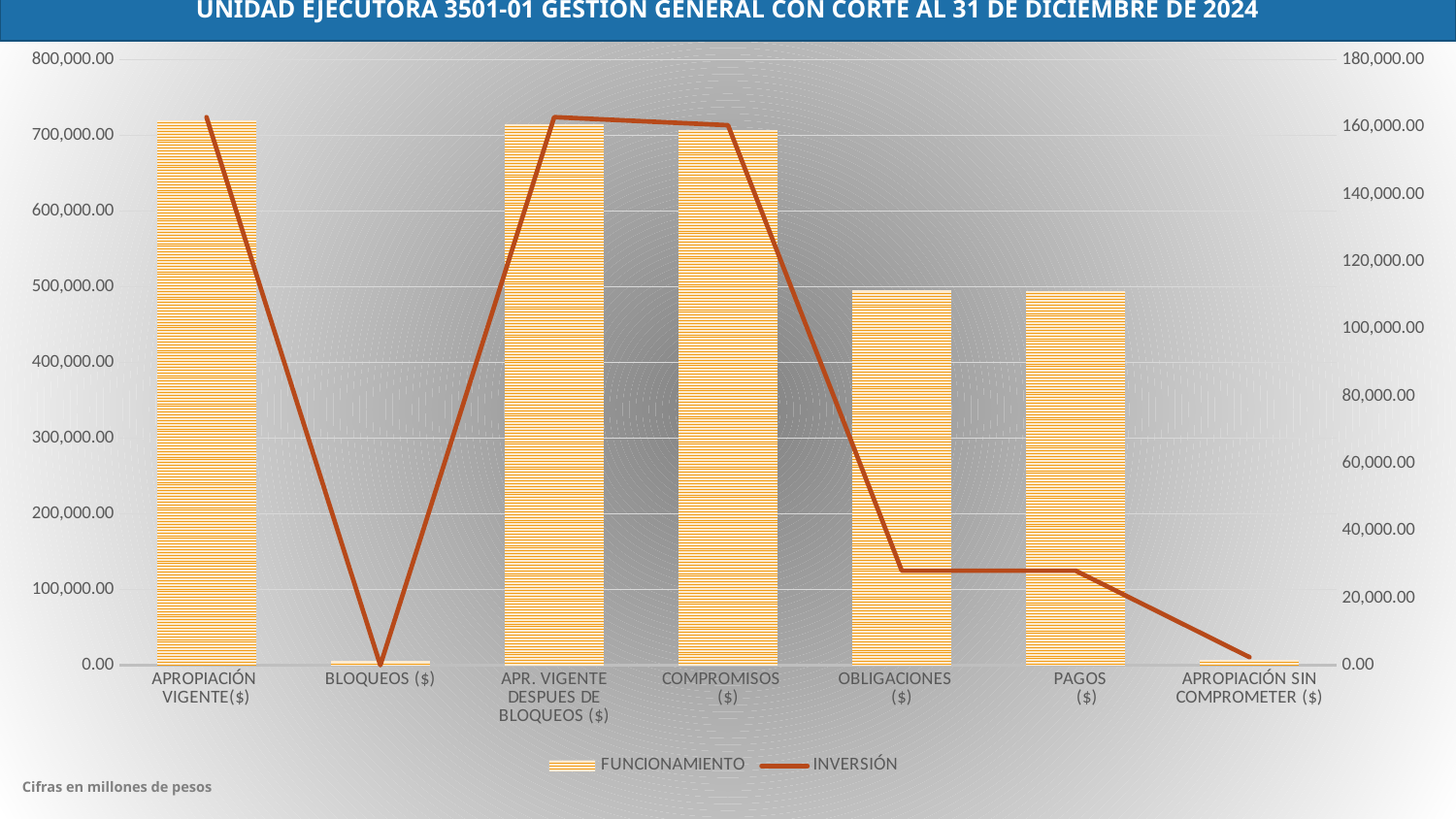
Is the FUNCIONAMIENTO value for OBLIGACIONES ($) greater or less than 400,000.00? greater What kind of chart is shown on the slide? A combined bar and line chart Is the FUNCIONAMIENTO value for APROPIACIÓN VIGENTE($) greater or less than 700,000.00? greater Which series is drawn as a line? INVERSIÓN How many series does the legend list? 2 Does the INVERSIÓN line rise or fall from COMPROMISOS ($) to OBLIGACIONES ($)? Fall Is the INVERSIÓN value for COMPROMISOS ($) greater or less than 140,000.00 on the right axis? greater How many categories are shown along the x axis? 7 Which has the larger FUNCIONAMIENTO value, COMPROMISOS ($) or OBLIGACIONES ($)? COMPROMISOS ($) According to the note on the slide, in what units are the figures expressed? Millones de pesos